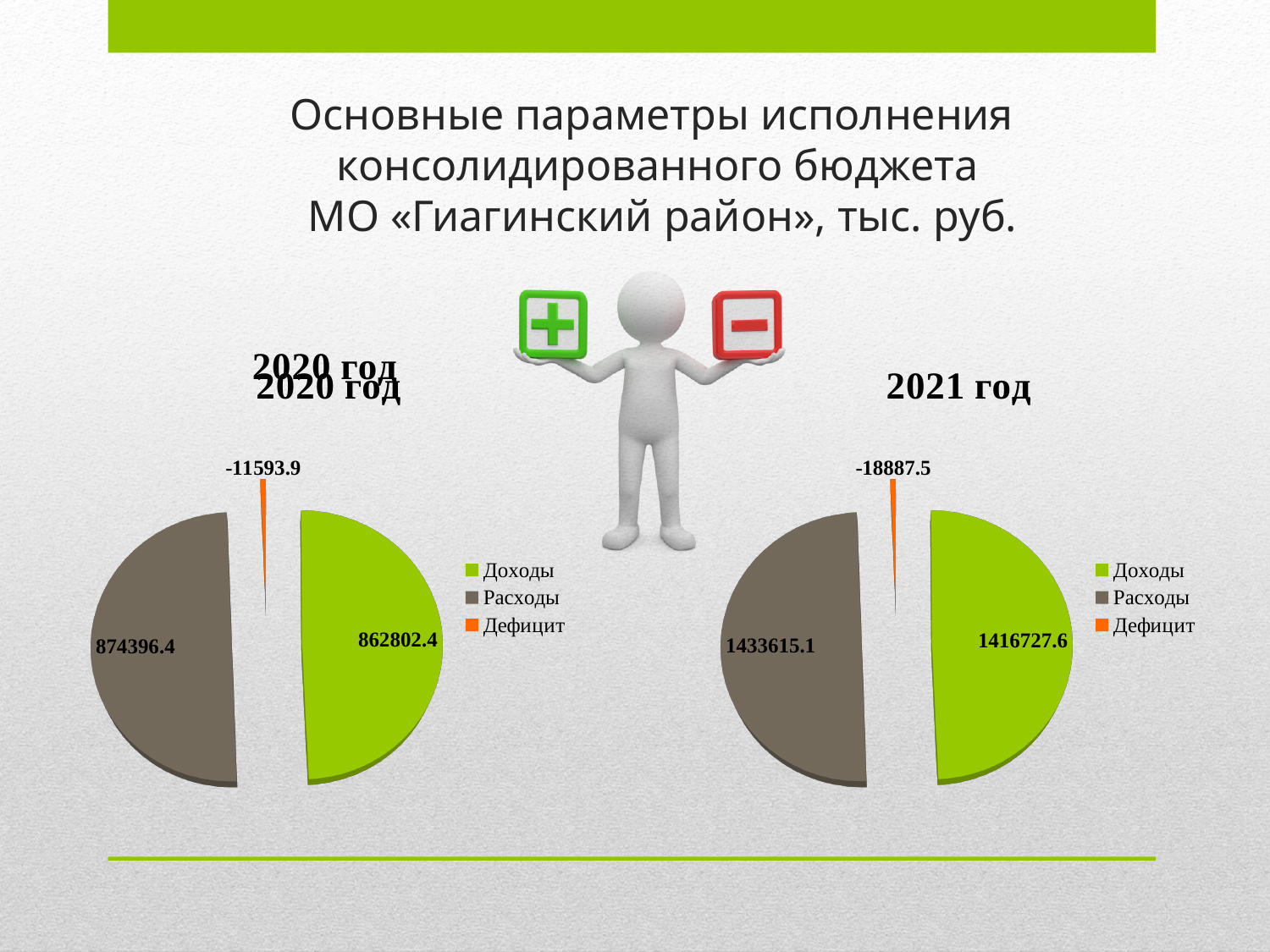
How many entries does the legend of the 2021 год chart list? 3 What kind of chart is the 2020 год chart? Pie chart In the 2021 год chart, what is the value for Дефицит? -18887.5 In the 2020 год chart, what colour is the Доходы slice? Green In the 2021 год chart, what is the value for Доходы? 1416727.6 What is the difference between Доходы in the 2021 год chart and Доходы in the 2020 год chart? 553925.2 In the 2021 год chart, what is the value for Расходы? 1433615.1 In the 2020 год chart, what is the value for Расходы? 874396.4 In the 2020 год chart, what is the value for Дефицит? -11593.9 In the 2020 год chart, what is the value for Доходы? 862802.4 In the 2020 год chart, which is larger, Доходы or Расходы? Расходы In the 2021 год chart, which category has the lowest value? Дефицит